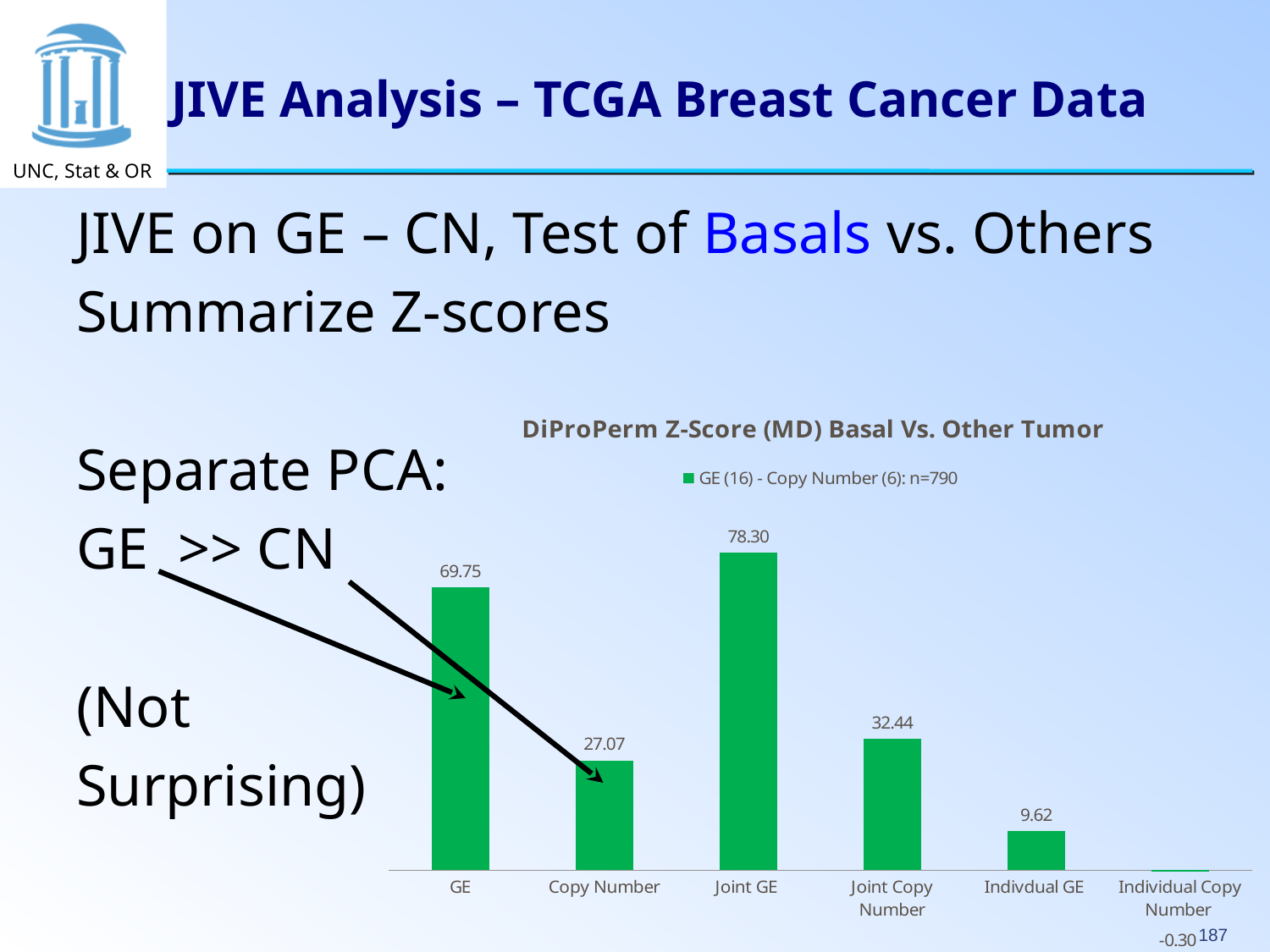
Which has a larger Z-score, Joint Copy Number or Indivdual GE? Joint Copy Number How many categories are shown on the x axis of the chart? 6 What is the difference between the Z-scores for GE and Copy Number? 42.68 What is the difference between the Z-scores for Joint GE and Joint Copy Number? 45.86 What is the Z-score value for Individual Copy Number? -0.30 What is the Z-score value for Joint GE? 78.30 Which category has the highest Z-score? Joint GE What is the Z-score value for Copy Number? 27.07 Which category has the lowest Z-score? Individual Copy Number How many series does the chart legend list? 1 What is the title of the chart? DiProPerm Z-Score (MD) Basal Vs. Other Tumor What kind of chart is shown on the slide? Bar chart